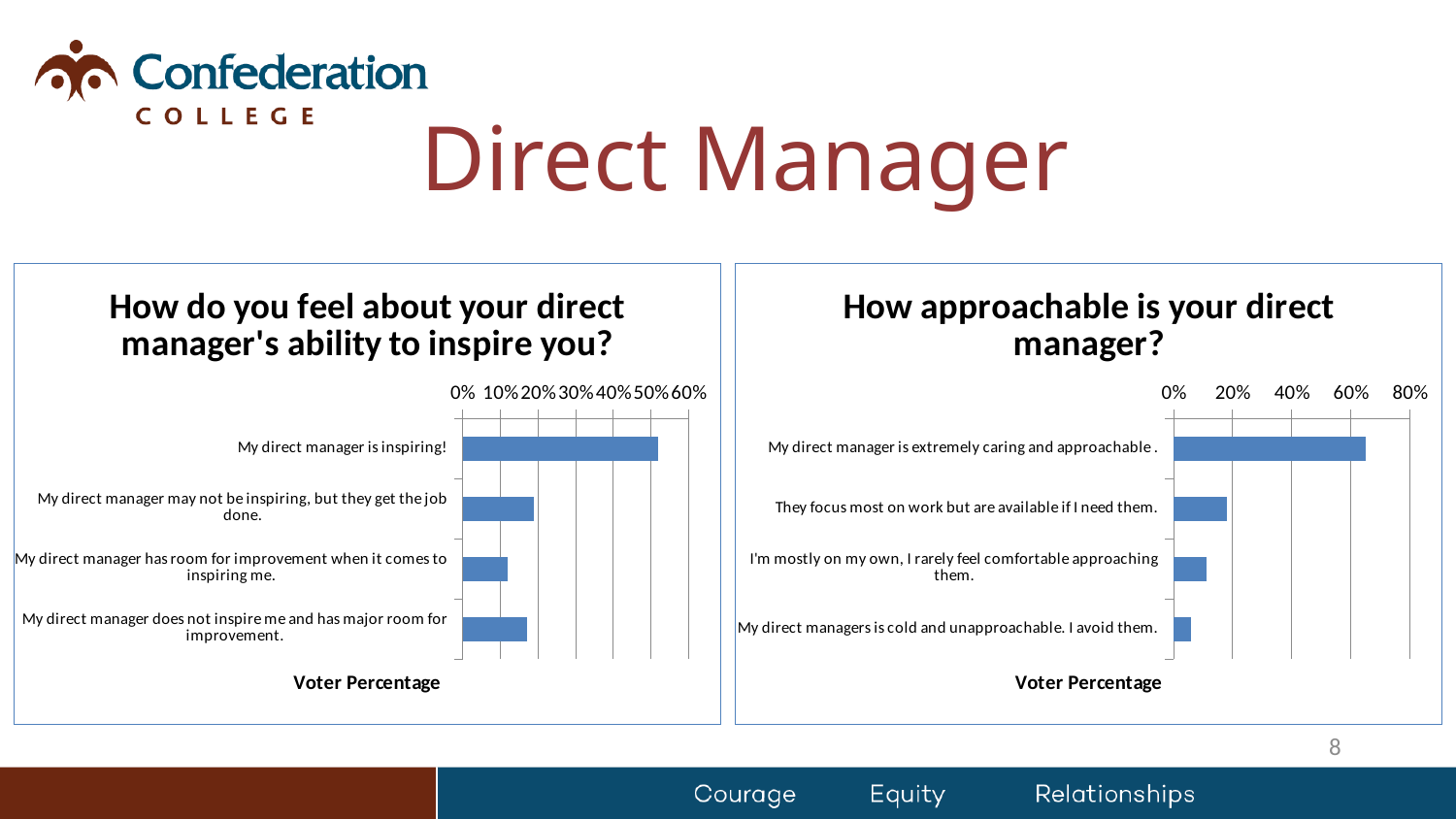
In the chart titled "How approachable is your direct manager?", which response has the lowest voter percentage? My direct managers is cold and unapproachable. I avoid them. In the chart titled "How do you feel about your direct manager's ability to inspire you?", which is larger: the value for "My direct manager is inspiring!" or the value for "My direct manager may not be inspiring, but they get the job done."? My direct manager is inspiring! In the chart titled "How do you feel about your direct manager's ability to inspire you?", is the value for "My direct manager is inspiring!" greater or less than 40%? greater In the chart titled "How do you feel about your direct manager's ability to inspire you?", which response has the highest voter percentage? My direct manager is inspiring! In the chart titled "How do you feel about your direct manager's ability to inspire you?", what is the label on the horizontal axis? Voter Percentage In the chart titled "How approachable is your direct manager?", which is larger: the value for "They focus most on work but are available if I need them." or the value for "My direct managers is cold and unapproachable. I avoid them."? They focus most on work but are available if I need them. In the chart titled "How approachable is your direct manager?", is the value for "My direct manager is extremely caring and approachable ." greater or less than 60%? greater In the chart titled "How approachable is your direct manager?", is the value for "They focus most on work but are available if I need them." greater or less than 40%? less In the chart titled "How approachable is your direct manager?", which response has the highest voter percentage? My direct manager is extremely caring and approachable . In the chart titled "How do you feel about your direct manager's ability to inspire you?", how many response categories are plotted? 4 In the chart titled "How do you feel about your direct manager's ability to inspire you?", what kind of chart is shown? Bar chart